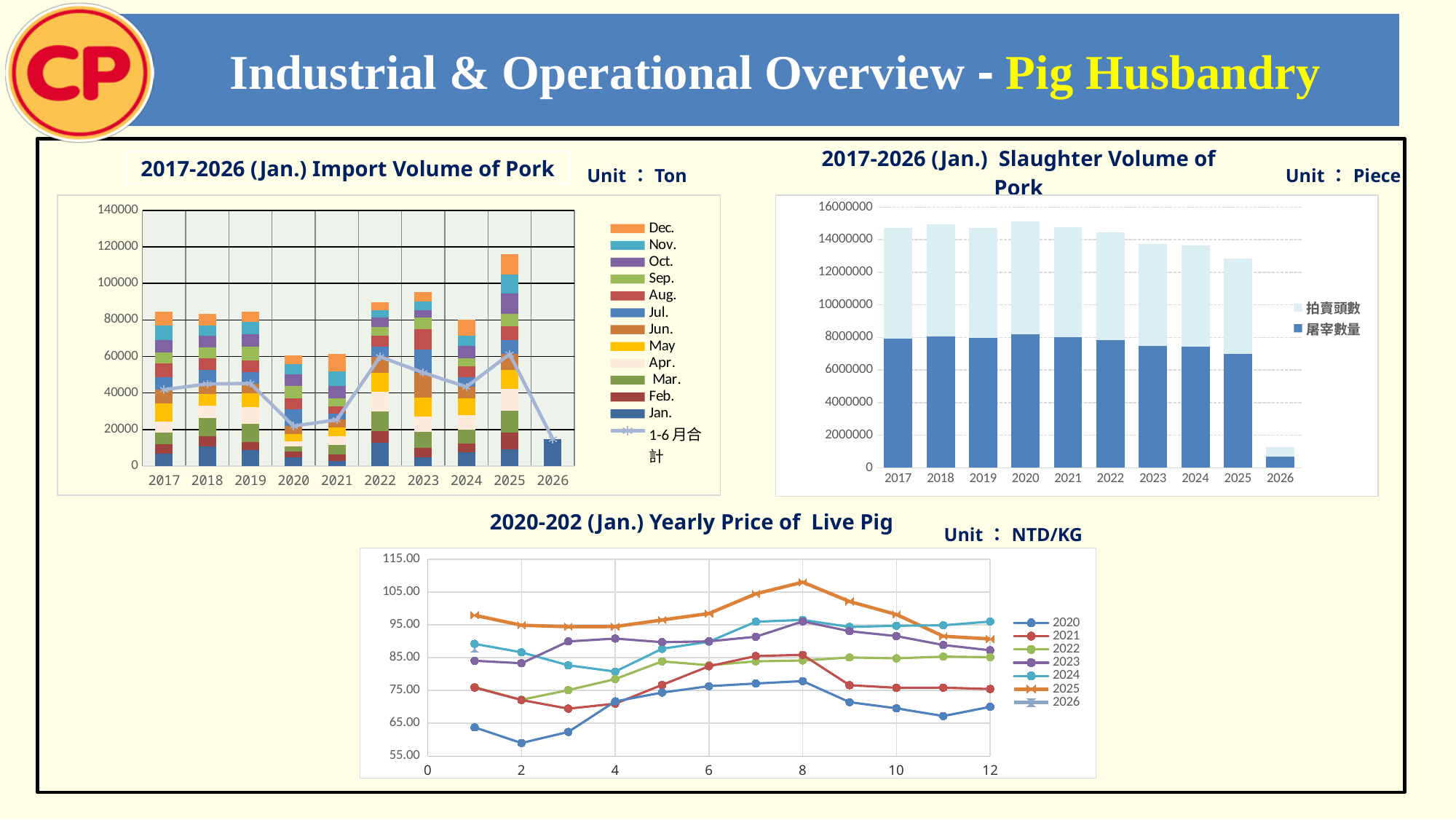
In the '2017-2026 (Jan.) Slaughter Volume of Pork' chart, which year has the shortest stacked bar? 2026 What kind of chart is the '2017-2026 (Jan.) Slaughter Volume of Pork' chart? bar chart What kind of chart is the '2020-202 (Jan.) Yearly Price of Live Pig' chart? line chart What unit is stated for the '2017-2026 (Jan.) Import Volume of Pork' chart? Ton In the '2020-202 (Jan.) Yearly Price of Live Pig' chart, is the 2025 value at month 8 greater or less than 105.00? greater How many series does the legend of the '2020-202 (Jan.) Yearly Price of Live Pig' chart list? 7 In the '2017-2026 (Jan.) Slaughter Volume of Pork' chart, is the total stacked bar for 2025 greater or less than 14000000? less In the '2020-202 (Jan.) Yearly Price of Live Pig' chart, which series is higher at month 6: 2025 or 2020? 2025 How many series does the legend of the '2017-2026 (Jan.) Slaughter Volume of Pork' chart list? 2 In the '2017-2026 (Jan.) Import Volume of Pork' chart, is the total stacked bar for 2025 greater or less than 100000? greater In the '2017-2026 (Jan.) Import Volume of Pork' chart, which year has the tallest stacked bar? 2025 In the '2017-2026 (Jan.) Import Volume of Pork' chart, how many years are shown on the x axis? 10